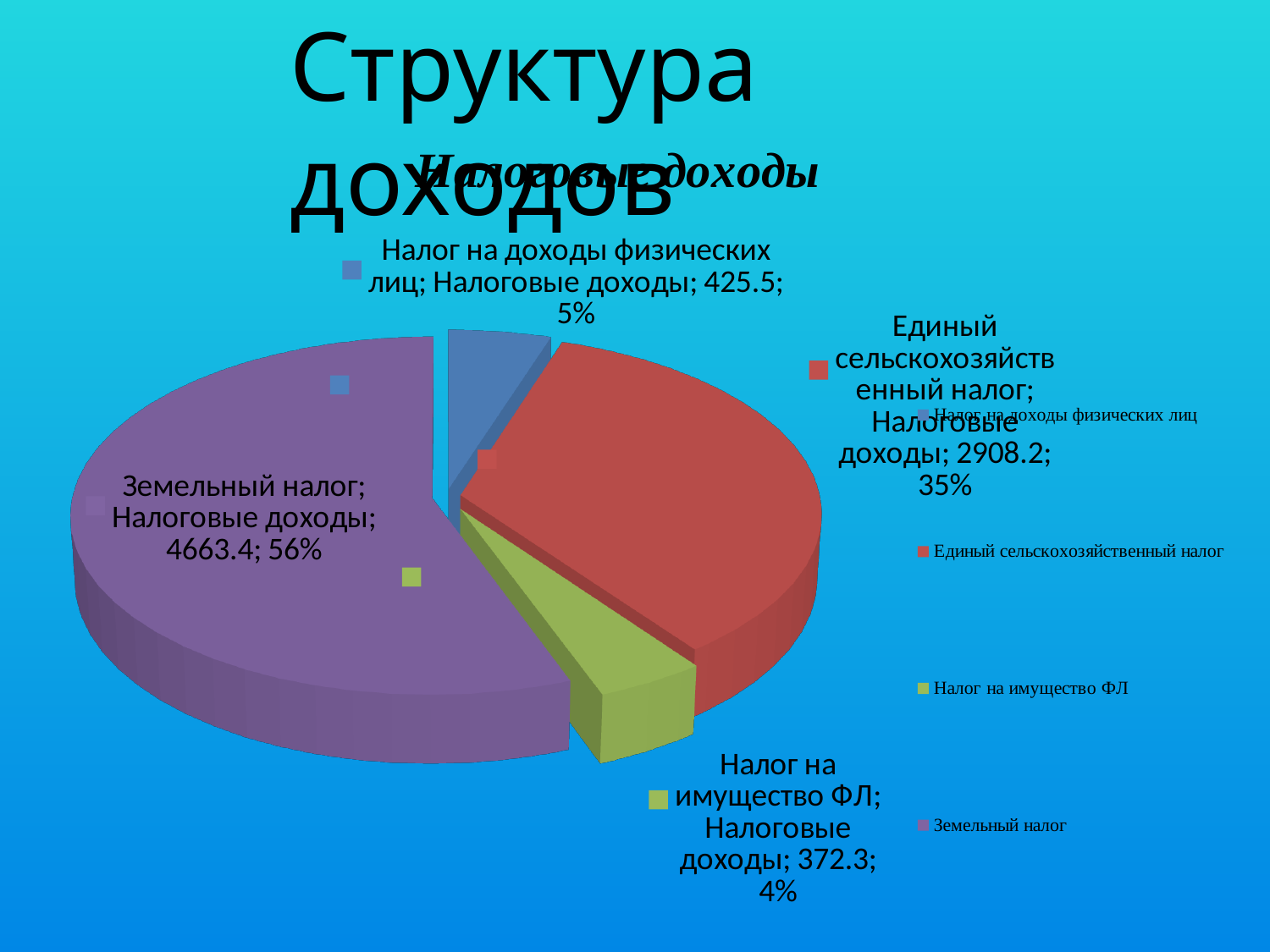
What kind of chart is shown on the slide? pie chart What is the value for Налог на имущество ФЛ? 372.3 Which is larger, the value for Налог на доходы физических лиц or the value for Налог на имущество ФЛ? Налог на доходы физических лиц What is the value for Налог на доходы физических лиц? 425.5 What is the value for Единый сельскохозяйственный налог? 2908.2 How many categories does the pie chart have? 4 What is the difference between the values for Земельный налог and Единый сельскохозяйственный налог? 1755.2 Which category has the largest slice of the pie? Земельный налог What share of the pie does Единый сельскохозяйственный налог represent? 35% Which category has the smallest slice of the pie? Налог на имущество ФЛ What share of the pie does Земельный налог represent? 56% What is the value for Земельный налог? 4663.4